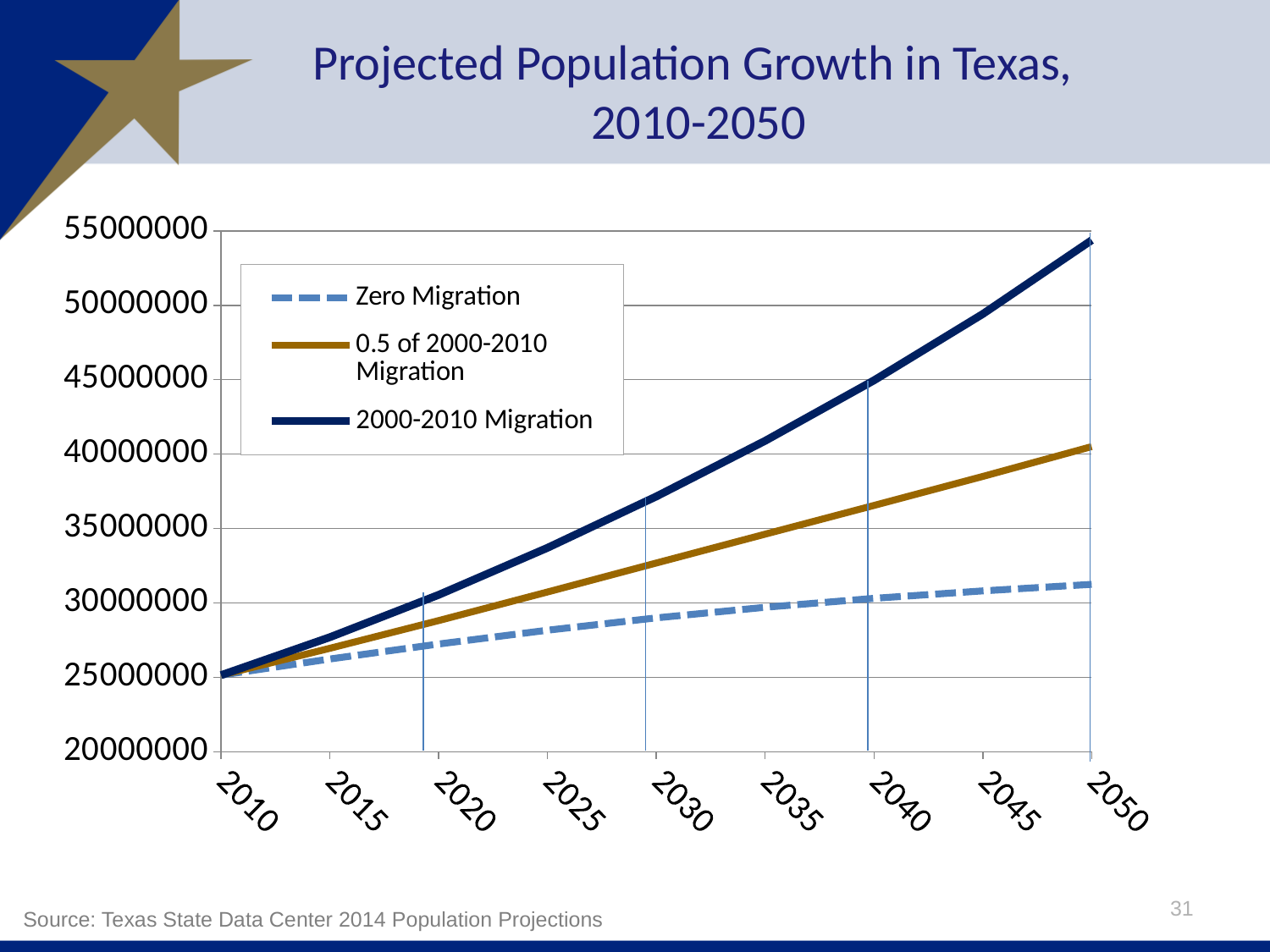
How many series does the legend list? 3 In 2050, which is larger: the 2000-2010 Migration value or the Zero Migration value? 2000-2010 Migration How many year labels are shown along the x axis? 9 Is the Zero Migration value for 2030 greater or less than 30000000? less Is the Zero Migration value for 2050 greater or less than 35000000? less Which series has the highest value in 2050? 2000-2010 Migration Which series has the lowest value in 2050? Zero Migration Is the 2000-2010 Migration value for 2050 greater or less than 50000000? greater What kind of chart is shown on the slide? Line chart Do the values for the 2000-2010 Migration series rise or fall from 2010 to 2050? Rise Which series is drawn with a dashed line? Zero Migration